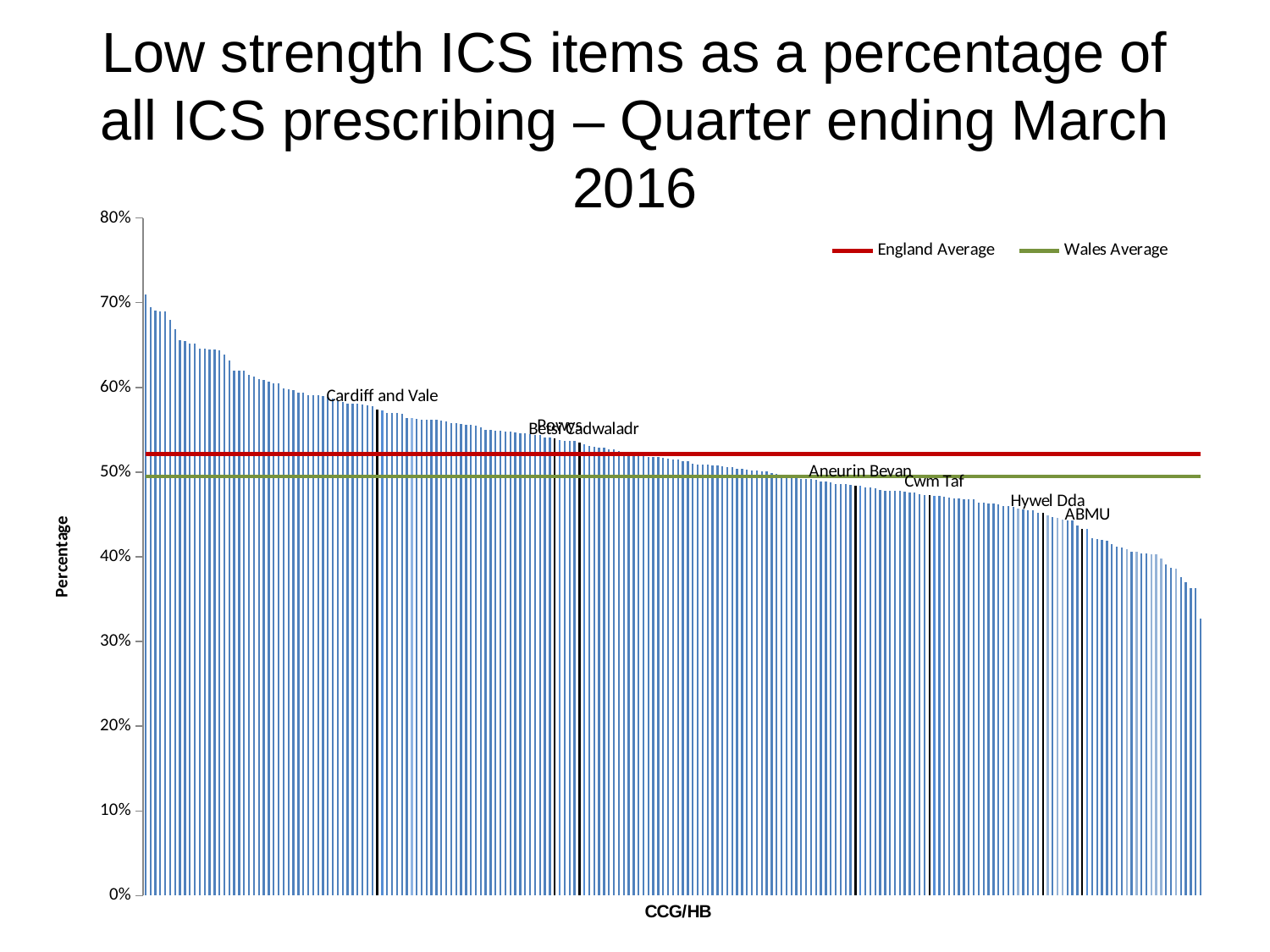
Which is higher, the England Average line or the Wales Average line? England Average Is the value for Powys greater or less than 50%? greater Do the bar values rise or fall from left to right along the x axis? Fall Which is larger, the value for Cardiff and Vale or the value for ABMU? Cardiff and Vale Is the England Average line greater or less than 60%? less What is the label on the x axis of the chart? CCG/HB What kind of chart is shown on the slide? Bar chart Is the value for Hywel Dda greater or less than 50%? less How many series does the legend list? 2 Among the labelled Welsh health boards, which has the highest value? Cardiff and Vale